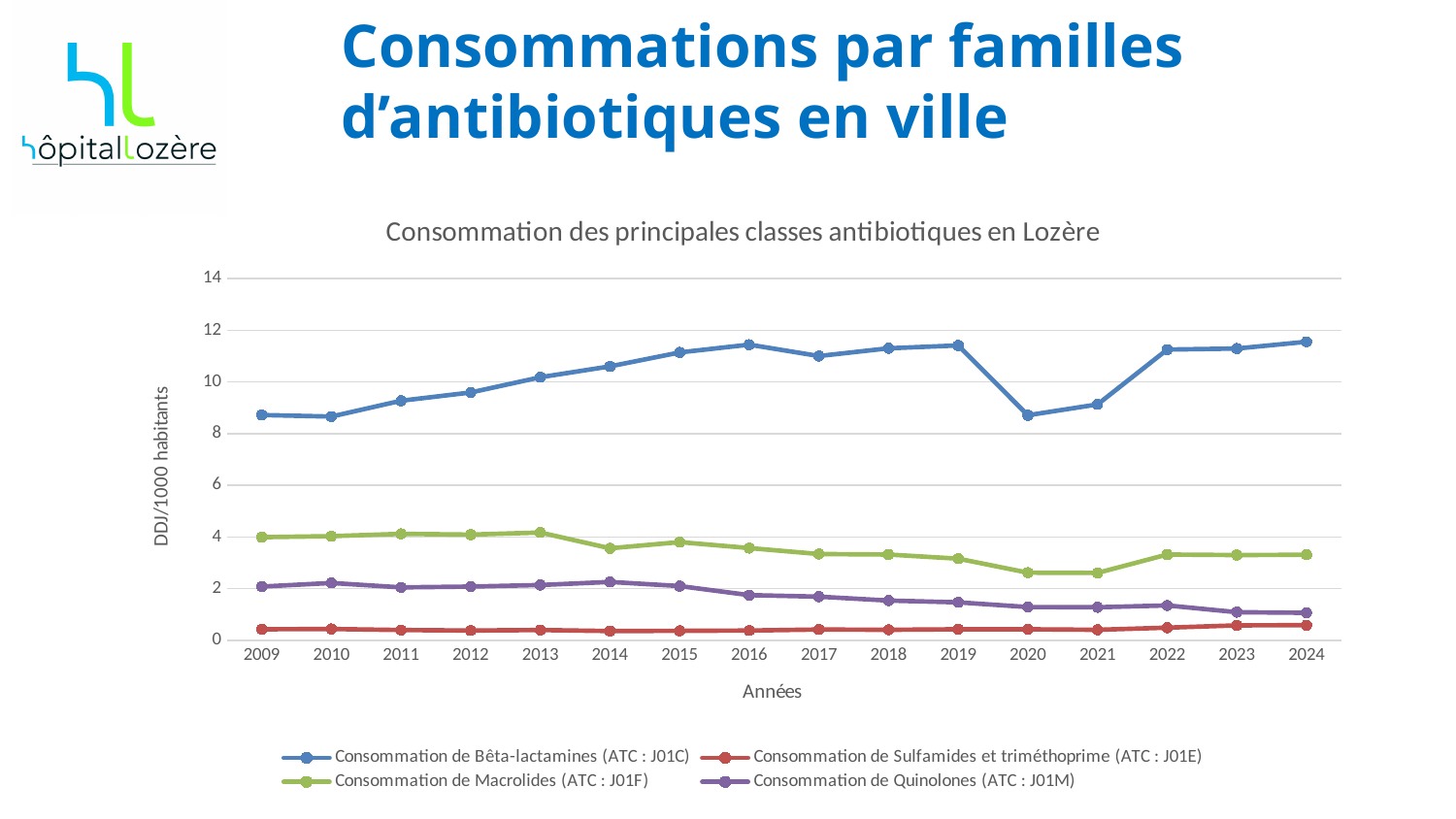
Which series has the highest values across the whole chart? Consommation de Bêta-lactamines (ATC : J01C) How many years are plotted along the x axis? 16 What kind of chart is shown on the slide? line chart How many series does the legend list? 4 Which series has the lowest values across the whole chart? Consommation de Sulfamides et triméthoprime (ATC : J01E) Is the value for Consommation de Bêta-lactamines (ATC : J01C) in 2016 greater or less than 10? greater What is the label of the y axis? DDJ/1000 habitants Is the value for Consommation de Quinolones (ATC : J01M) in 2024 greater or less than 2? less Do the values for Consommation de Quinolones (ATC : J01M) rise or fall from 2009 to 2024? fall Is the value for Consommation de Bêta-lactamines (ATC : J01C) in 2020 greater or less than 10? less In 2024, which is larger: Consommation de Bêta-lactamines (ATC : J01C) or Consommation de Macrolides (ATC : J01F)? Consommation de Bêta-lactamines (ATC : J01C)